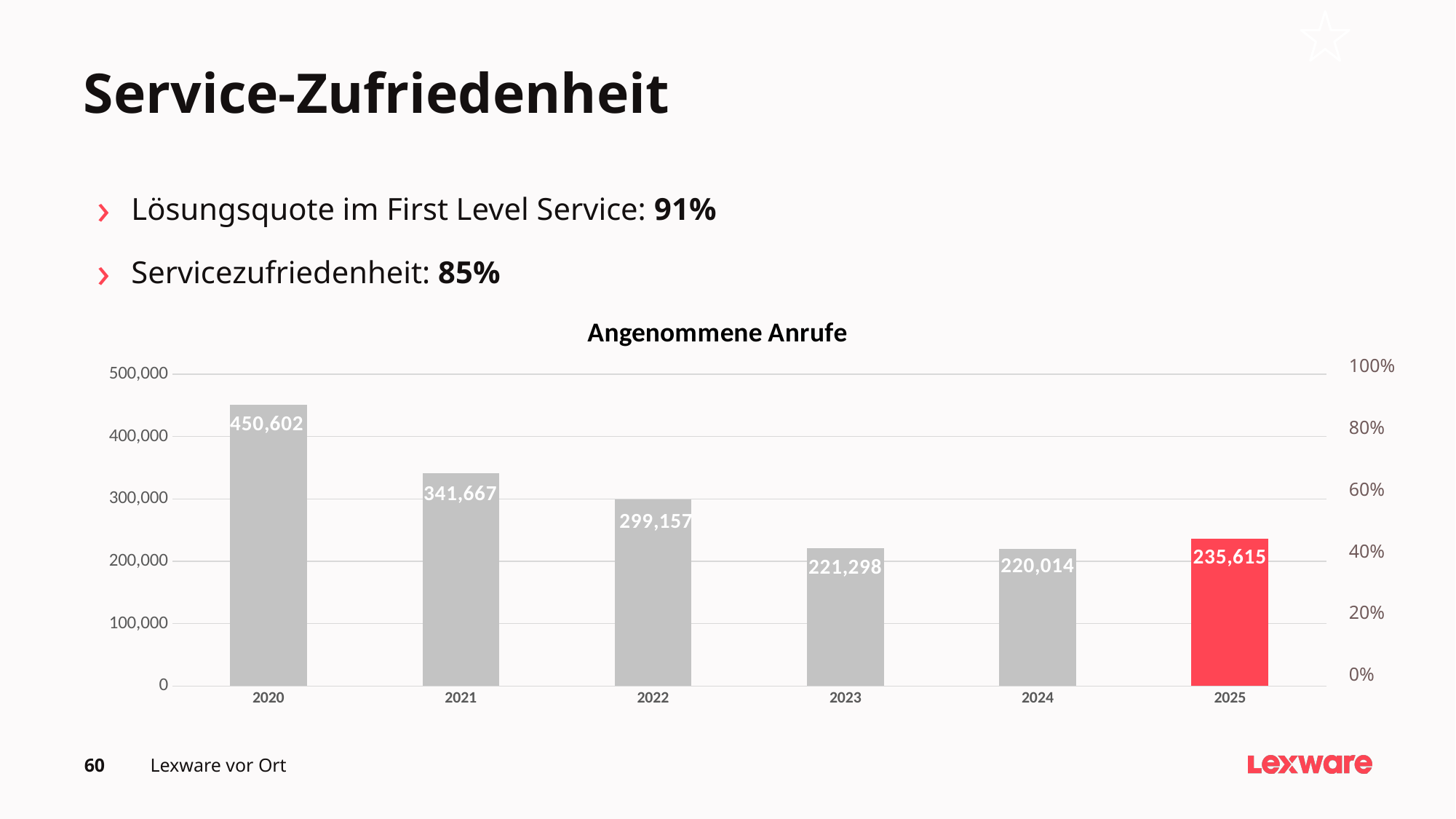
Which year has the highest value in the Angenommene Anrufe chart? 2020 What is the difference between the values for 2025 and 2024 in the Angenommene Anrufe chart? 15,601 What kind of chart is the Angenommene Anrufe chart? bar chart Which bar in the Angenommene Anrufe chart is coloured red instead of grey? 2025 What is the value for 2025 in the Angenommene Anrufe chart? 235,615 Which year has the lowest value in the Angenommene Anrufe chart? 2024 What is the value for 2020 in the Angenommene Anrufe chart? 450,602 Which is larger in the Angenommene Anrufe chart, the value for 2022 or the value for 2025? 2022 How many years are shown on the x axis of the Angenommene Anrufe chart? 6 What is the difference between the values for 2020 and 2021 in the Angenommene Anrufe chart? 108,935 Is the value for 2021 in the Angenommene Anrufe chart greater or less than 300,000? greater What is the value for 2023 in the Angenommene Anrufe chart? 221,298